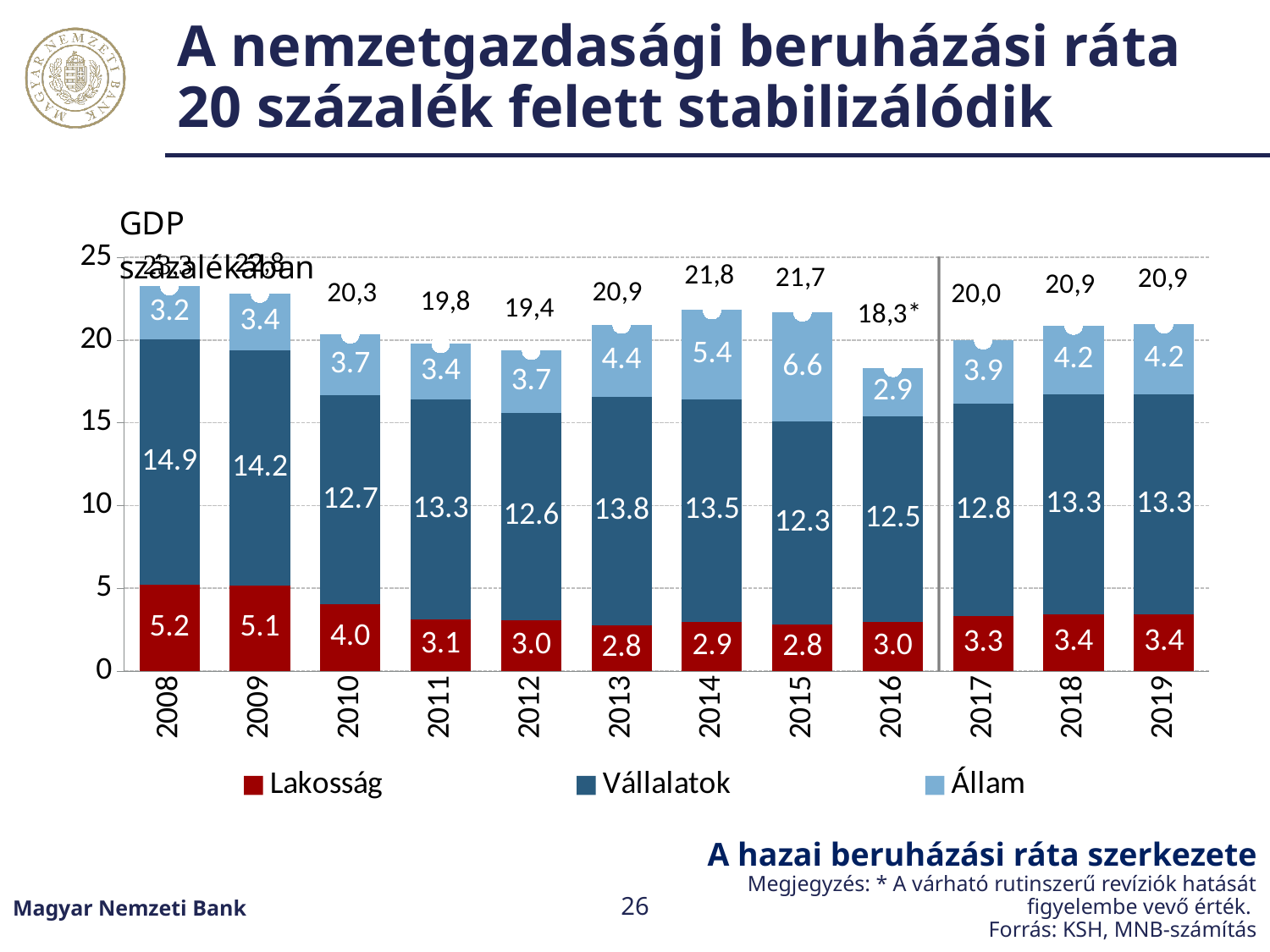
What is the total of the stacked bar for 2015? 21,7 Which is larger, the Állam value in 2013 or in 2016? 2013 What is the value for Lakosság in 2010? 4.0 What is the value for Állam in 2014? 5.4 What is the difference between the Lakosság values for 2008 and 2019? 1.8 How many years are shown on the x axis? 12 How many series does the legend list? 3 In which year is the Állam segment the highest? 2015 Which series is shown in red in the legend? Lakosság In which year is the Vállalatok segment the lowest? 2015 What kind of chart is shown on the slide? Stacked bar chart What is the value for Vállalatok in 2008? 14.9